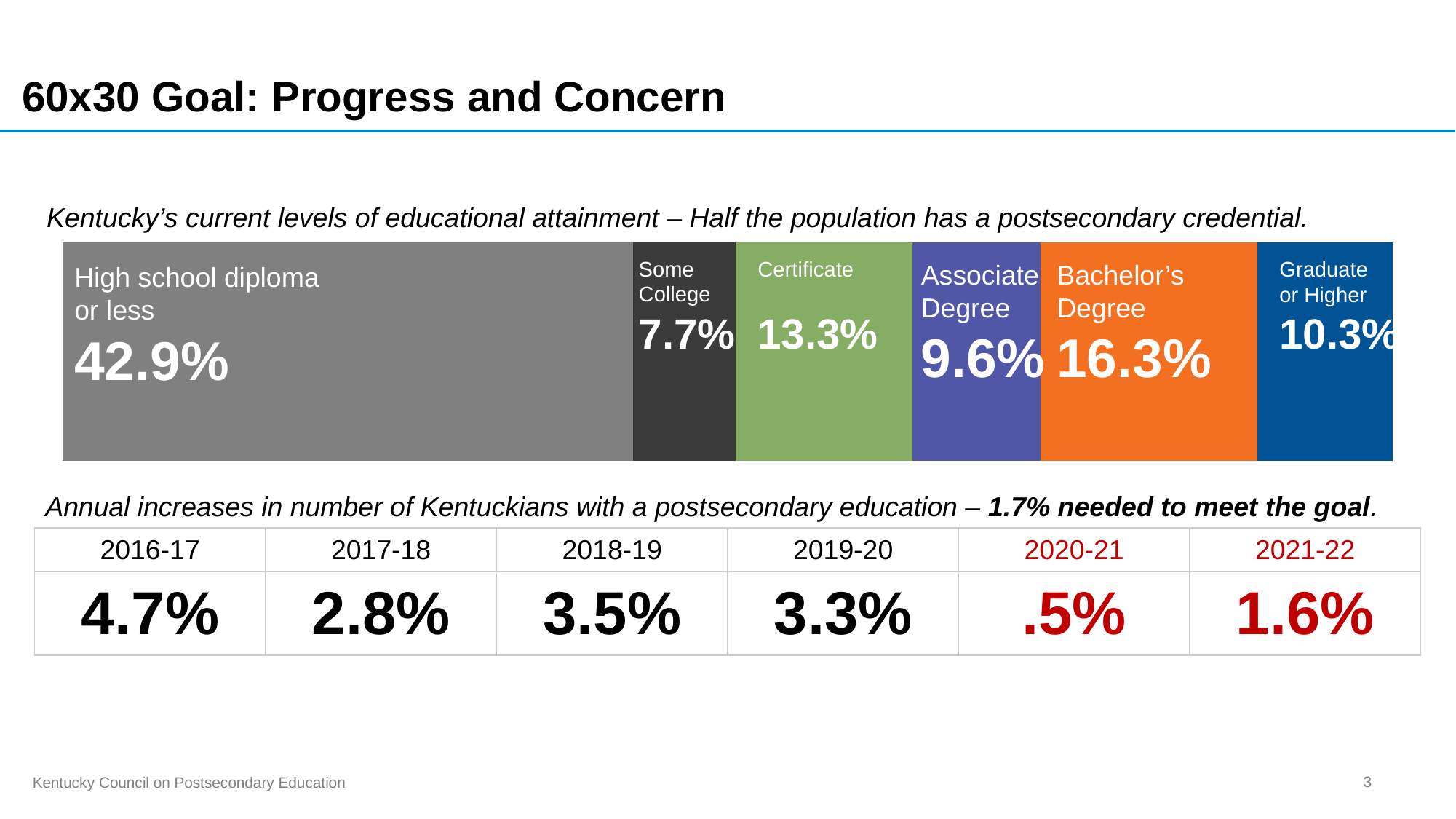
In the educational attainment bar, which category has the largest share? High school diploma or less In the educational attainment bar, what is the value for Certificate? 13.3% In the annual increases table, which year had the lowest increase? 2020-21 In the educational attainment bar, what percentage has Some College? 7.7% In the educational attainment bar, which is larger: Graduate or Higher or Associate Degree? Graduate or Higher In the educational attainment bar, what share of Kentucky's population has a high school diploma or less? 42.9% In the educational attainment bar, what percentage holds a Bachelor's Degree? 16.3% In the educational attainment bar, what colour is the Bachelor's Degree segment? Orange How many attainment categories are shown in the educational attainment bar? 6 What kind of chart is used to show Kentucky's current levels of educational attainment? Stacked bar chart In the educational attainment bar, which category has the smallest share? Some College In the educational attainment bar, how many percentage points higher is Bachelor's Degree than Associate Degree? 6.7 percentage points